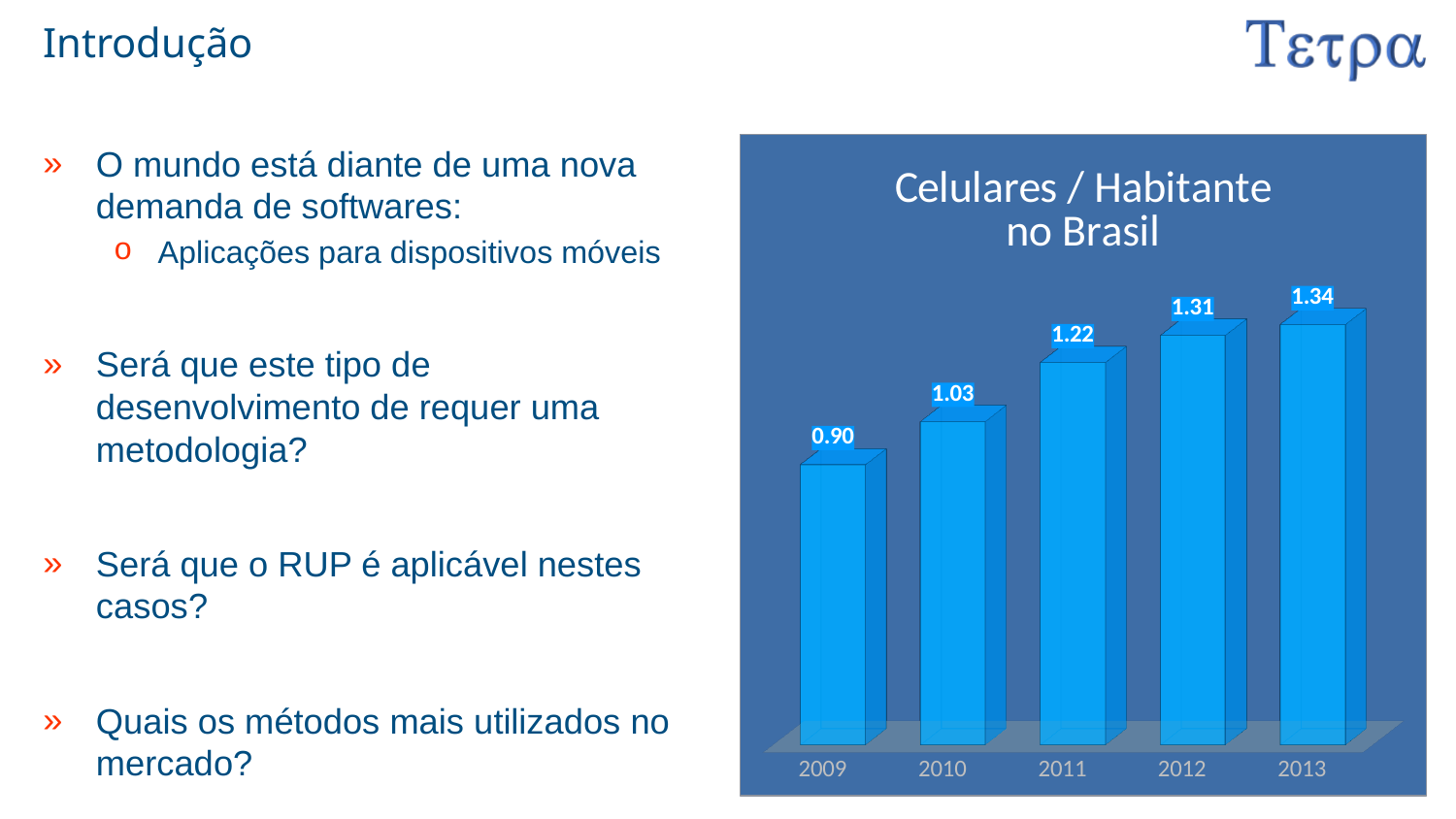
What is the difference between the values for 2011 and 2010? 0.19 What is the title of the chart? Celulares / Habitante no Brasil What is the value for 2013 in the chart? 1.34 How many years are shown in the chart? 5 What is the value for 2009 in the chart? 0.90 Which is larger, the value for 2010 or the value for 2012? 2012 Do the values rise or fall from 2009 to 2013? Rise What kind of chart is shown on the slide? Bar chart What is the value for 2011 in the chart? 1.22 Which year has the lowest value in the chart? 2009 Which year has the highest value in the chart? 2013 What is the difference between the values for 2013 and 2009? 0.44